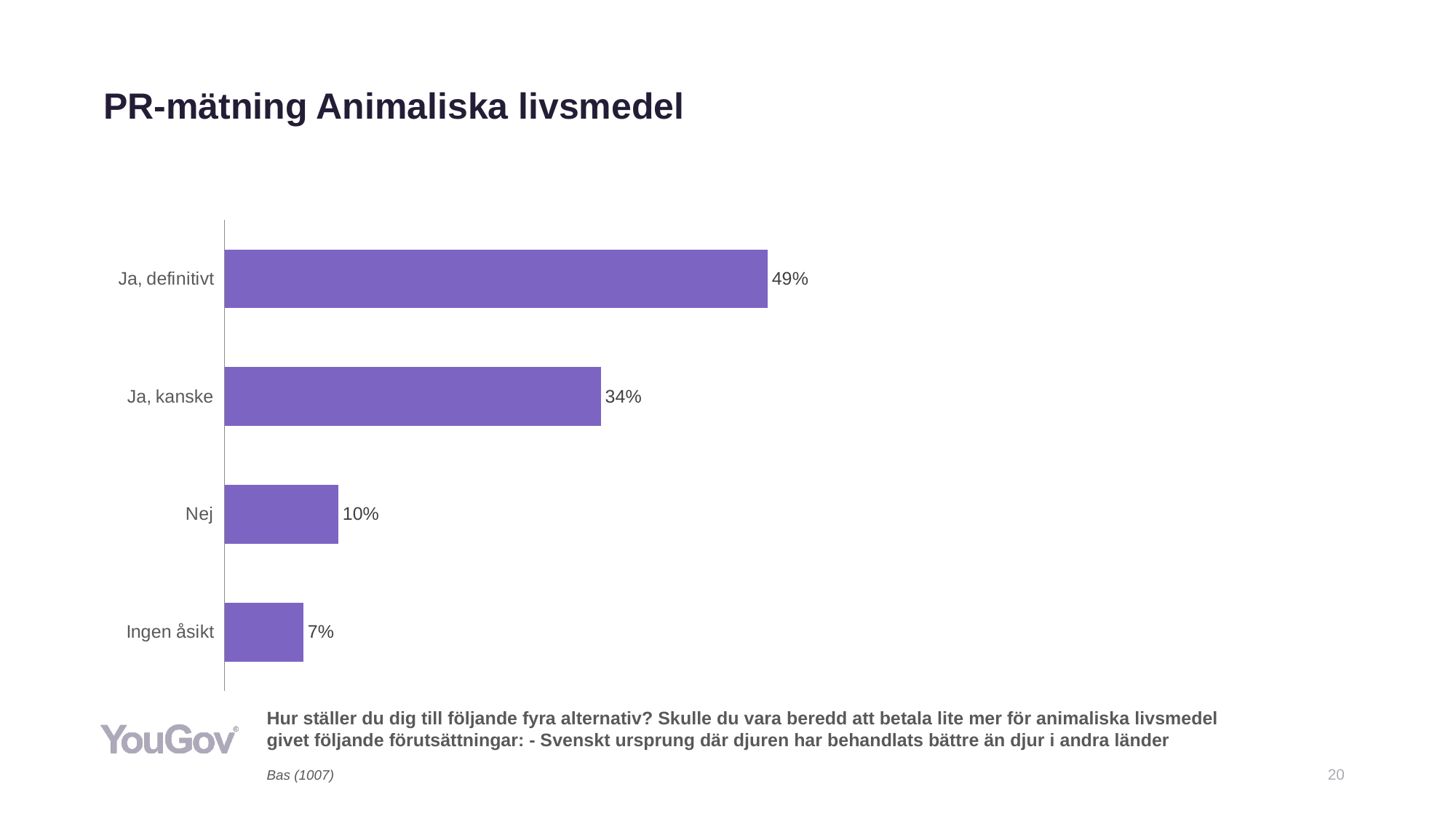
Which category has the lowest value? Ingen åsikt Which category has the highest value? Ja, definitivt What is the value for "Ja, kanske"? 34% What is the value for "Ingen åsikt"? 7% What is the difference between the values for "Nej" and "Ingen åsikt"? 3% What is the base (Bas) sample size stated below the chart? 1007 What kind of chart is shown on the slide? Bar chart What is the difference between the values for "Ja, definitivt" and "Ja, kanske"? 15% How many categories are shown in the chart? 4 Which is larger, the value for "Ja, kanske" or the value for "Nej"? Ja, kanske What is the value for "Nej"? 10% What is the value for "Ja, definitivt"? 49%